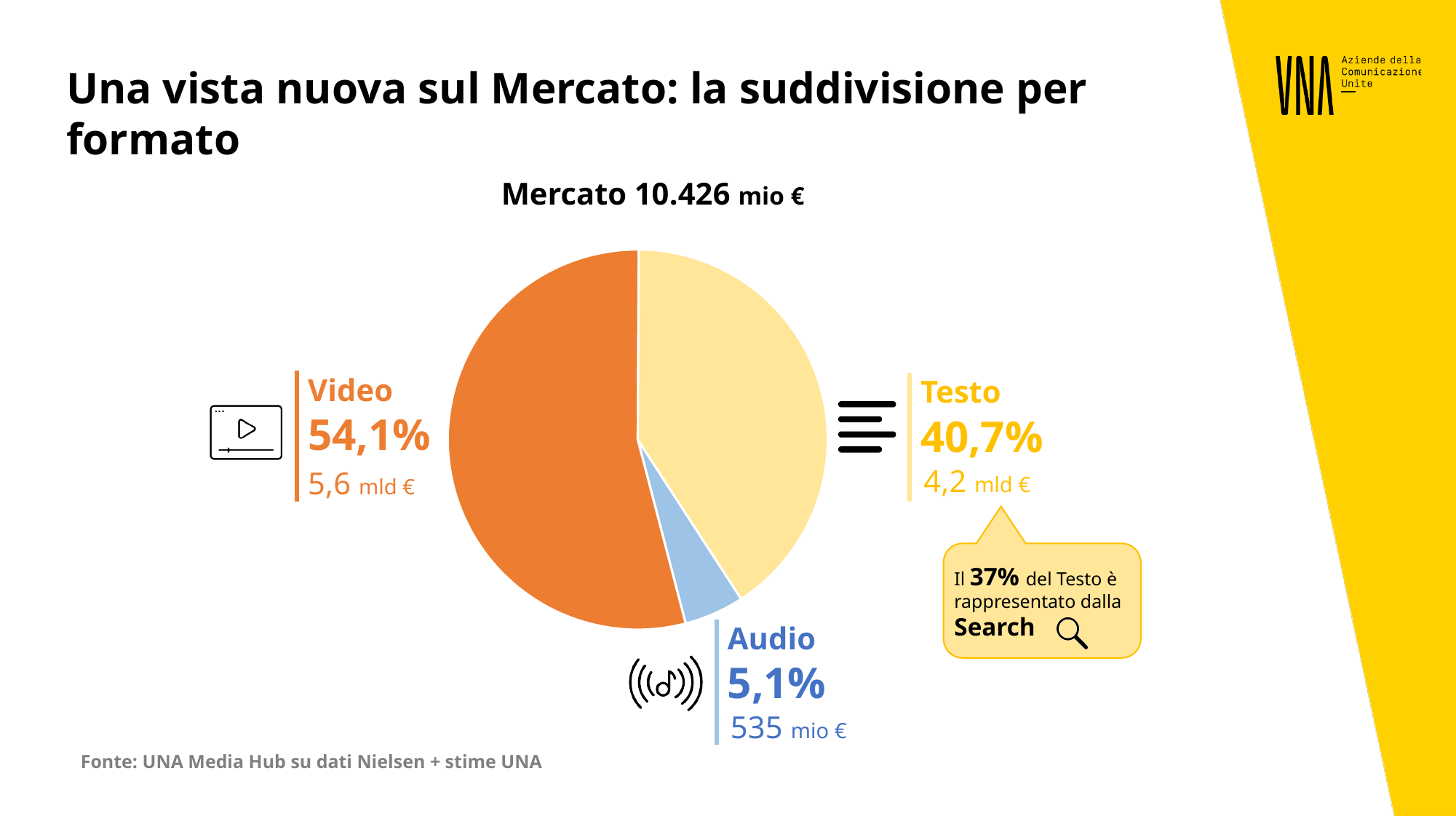
What is the value in euros shown for Video? 5,6 mld € What share of the market does Audio represent? 5,1% What is the difference in percentage points between the Video and Testo shares? 13,4 What is the value in euros shown for Audio? 535 mio € What share of the market does Testo represent? 40,7% What share of the market does Video represent? 54,1% What total market value is given in the chart title? 10.426 mio € How many formats are shown in the pie chart? 3 Which has a larger share, Testo or Audio? Testo What kind of chart is shown on the slide? pie chart Which format has the smallest slice of the pie? Audio Which format has the largest slice of the pie? Video